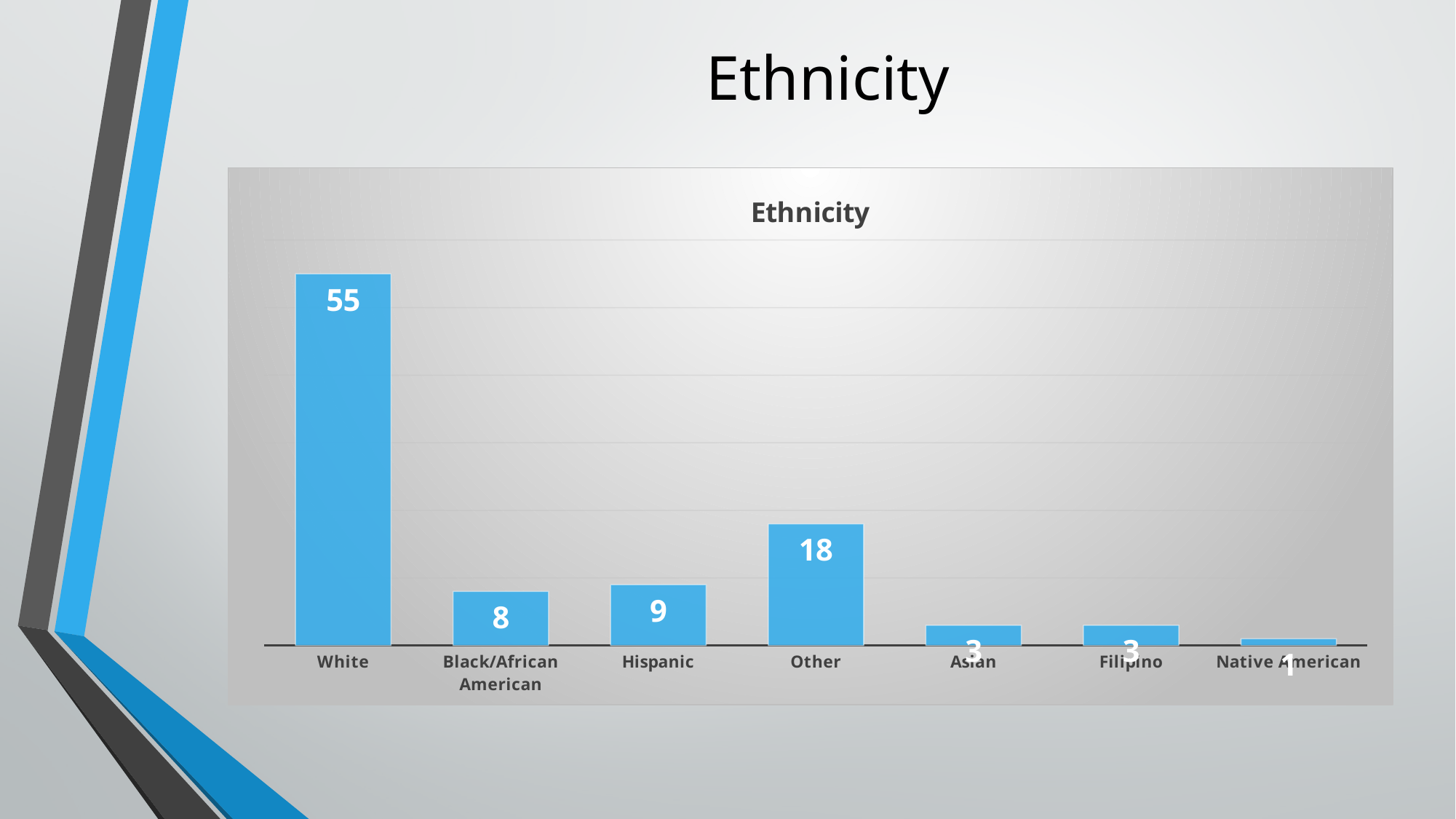
What is the value for Hispanic? 9 What kind of chart is shown on the slide? Bar chart Which category has the lowest value? Native American Which is larger, the value for Hispanic or the value for Black/African American? Hispanic How many categories are shown on the x axis? 7 Which category has the highest value? White What is the value for Other? 18 What is the value for Native American? 1 What is the difference between the values for White and Other? 37 What is the value for Black/African American? 8 What is the value for White? 55 What is the title of the chart? Ethnicity